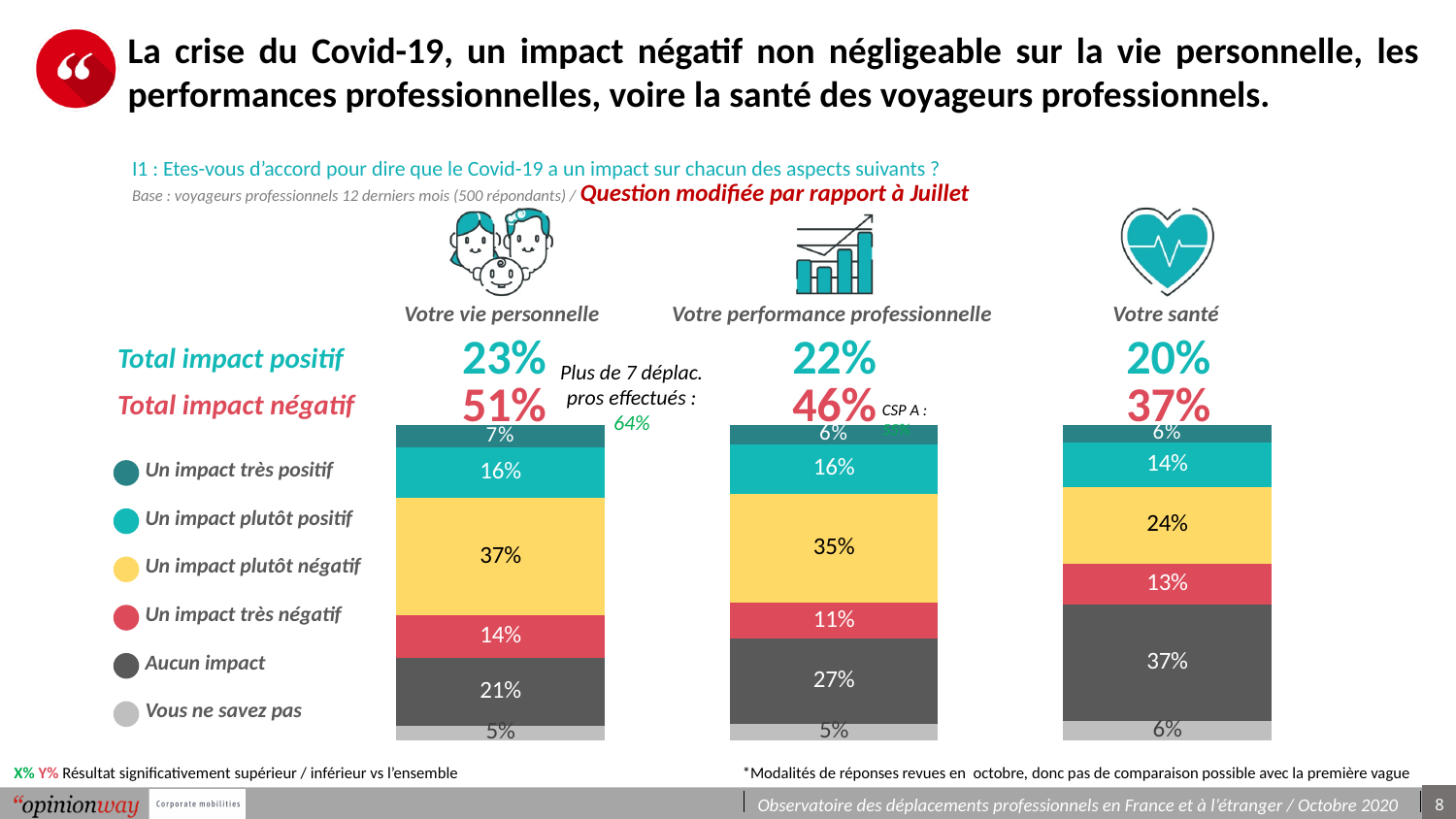
Which of the three aspects has the highest 'Total impact négatif'? Votre vie personnelle How many response categories does the legend list for the stacked bars? 6 In the 'Votre vie personnelle' bar, what percentage reported 'Un impact plutôt négatif'? 37% What type of chart is used to show the responses for each aspect? Stacked bar chart What is the difference between 'Total impact négatif' for 'Votre vie personnelle' and for 'Votre santé'? 14 percentage points In the 'Votre santé' bar, what percentage reported 'Aucun impact'? 37% Which of the three aspects has the lowest 'Total impact positif'? Votre santé What is the 'Total impact négatif' value shown for 'Votre performance professionnelle'? 46% Is the 'Un impact plutôt positif' share larger for 'Votre vie personnelle' or for 'Votre santé'? Votre vie personnelle How many stacked bars (aspects) are shown on the slide? 3 In the 'Votre performance professionnelle' bar, what percentage reported 'Un impact très négatif'? 11% Which colour represents 'Un impact plutôt négatif' in the legend? Yellow